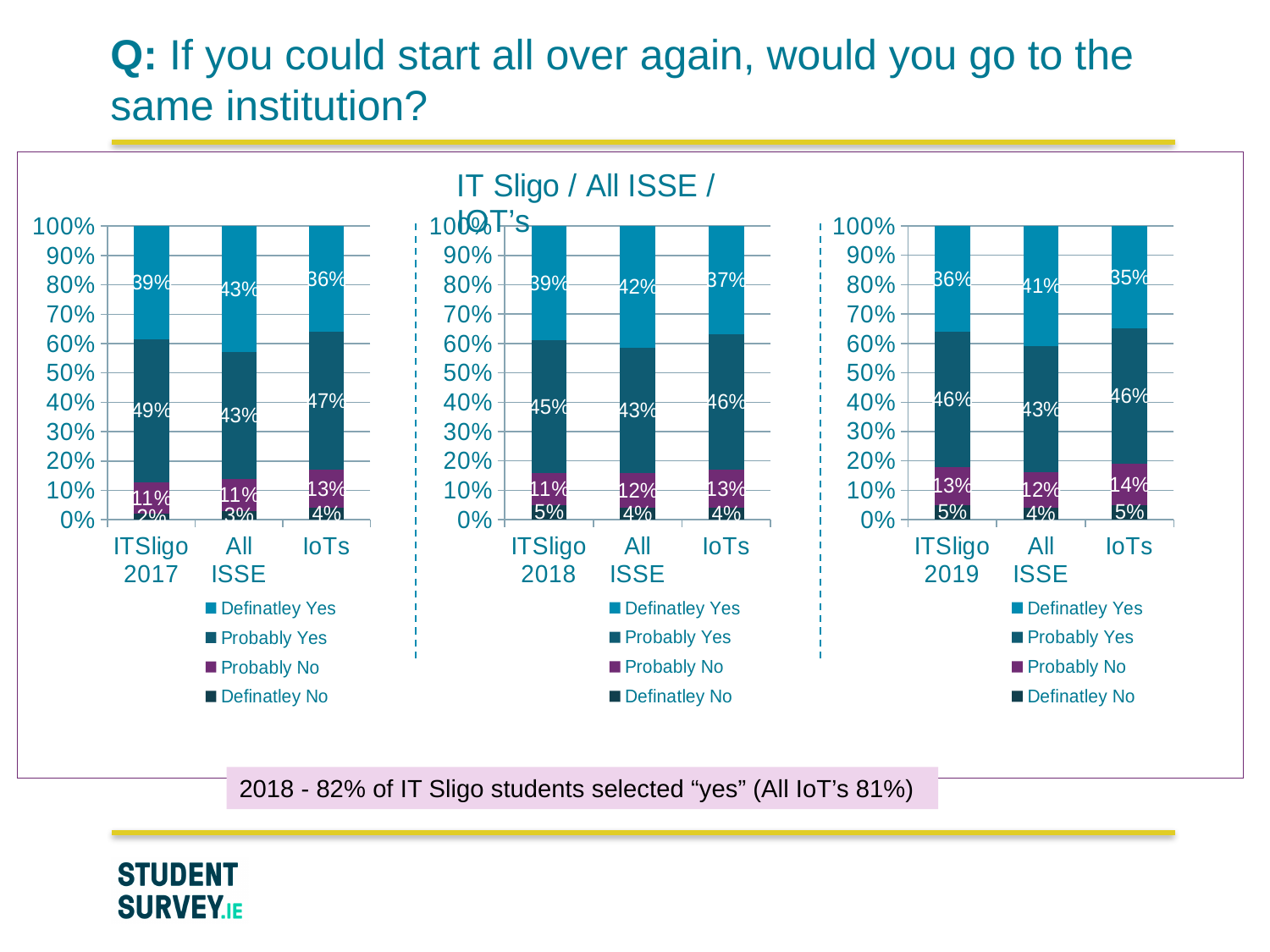
In the middle chart, which category has the highest Definately Yes value? All ISSE In the middle chart, what is the Definately No value for ITSligo 2018? 5% How many categories are shown on the x axis of the right chart? 3 In the left chart, what is the Definately Yes value for All ISSE? 43% In the right chart, what is the Probably No value for IoTs? 14% In the right chart, what is the Definately Yes value for ITSligo 2019? 36% How many series does the legend of the left chart list? 4 What type of chart is the middle chart? Stacked bar chart In the left chart, what is the Probably Yes value for ITSligo 2017? 49% In the left chart, which category has the lowest Definately No value? ITSligo 2017 In the right chart, which is larger: the Definately Yes value for All ISSE or for IoTs? All ISSE In the middle chart, what is the difference between the Probably Yes values for IoTs and ITSligo 2018? 1%